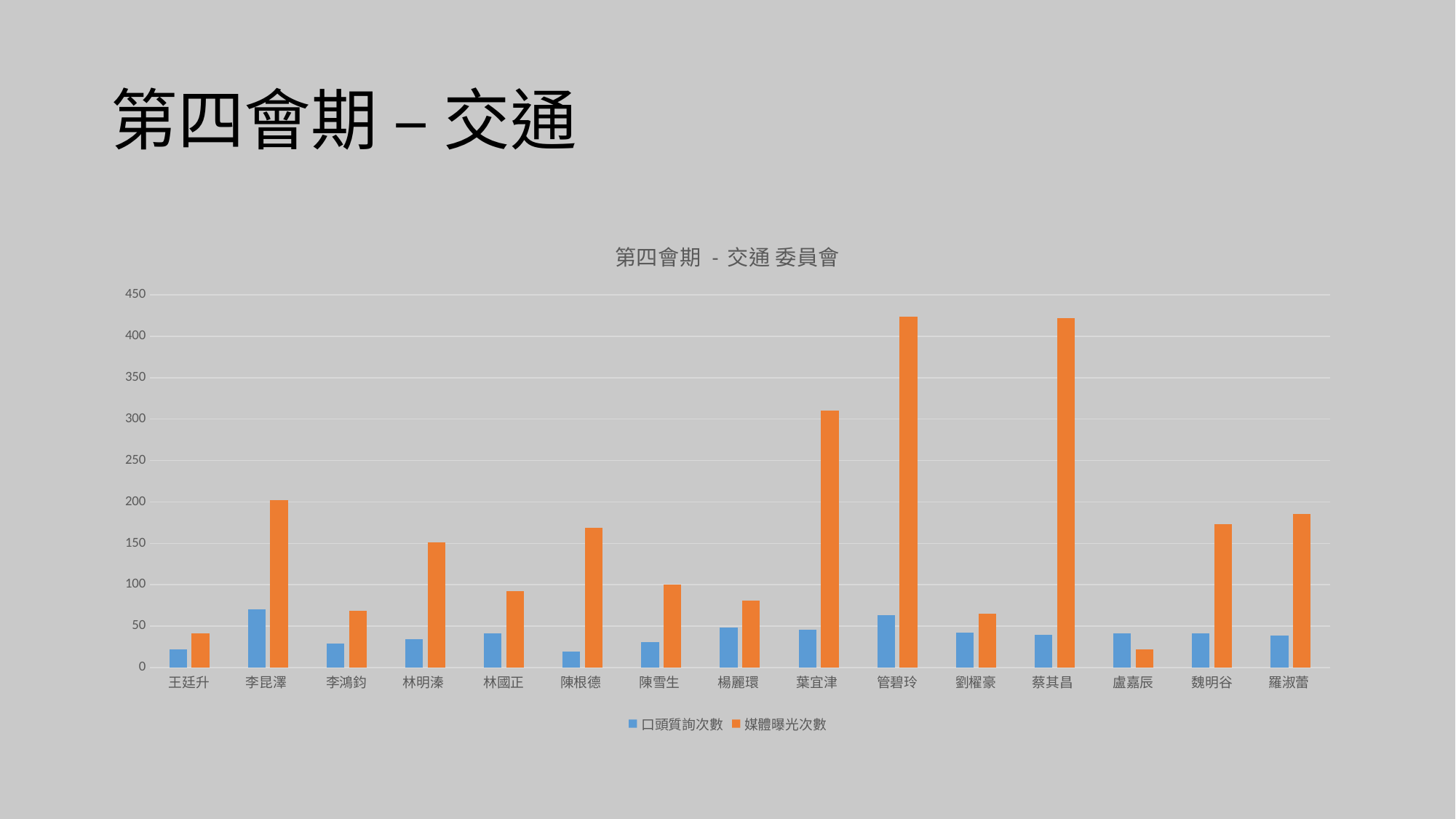
Which legislator has the lowest 媒體曝光次數 value? 盧嘉辰 Is the 媒體曝光次數 value for 盧嘉辰 greater or less than 50? less Which has the larger 媒體曝光次數 value, 李昆澤 or 李鴻鈞? 李昆澤 What kind of chart is shown on the slide? bar chart For 盧嘉辰, which series has the larger value, 口頭質詢次數 or 媒體曝光次數? 口頭質詢次數 What is the title of the chart? 第四會期 - 交通 委員會 Is the 口頭質詢次數 value for 王廷升 greater or less than 50? less How many legislators (categories) are shown on the x axis of the chart? 15 How many series does the chart's legend list? 2 Is the 媒體曝光次數 value for 葉宜津 greater or less than 250? greater